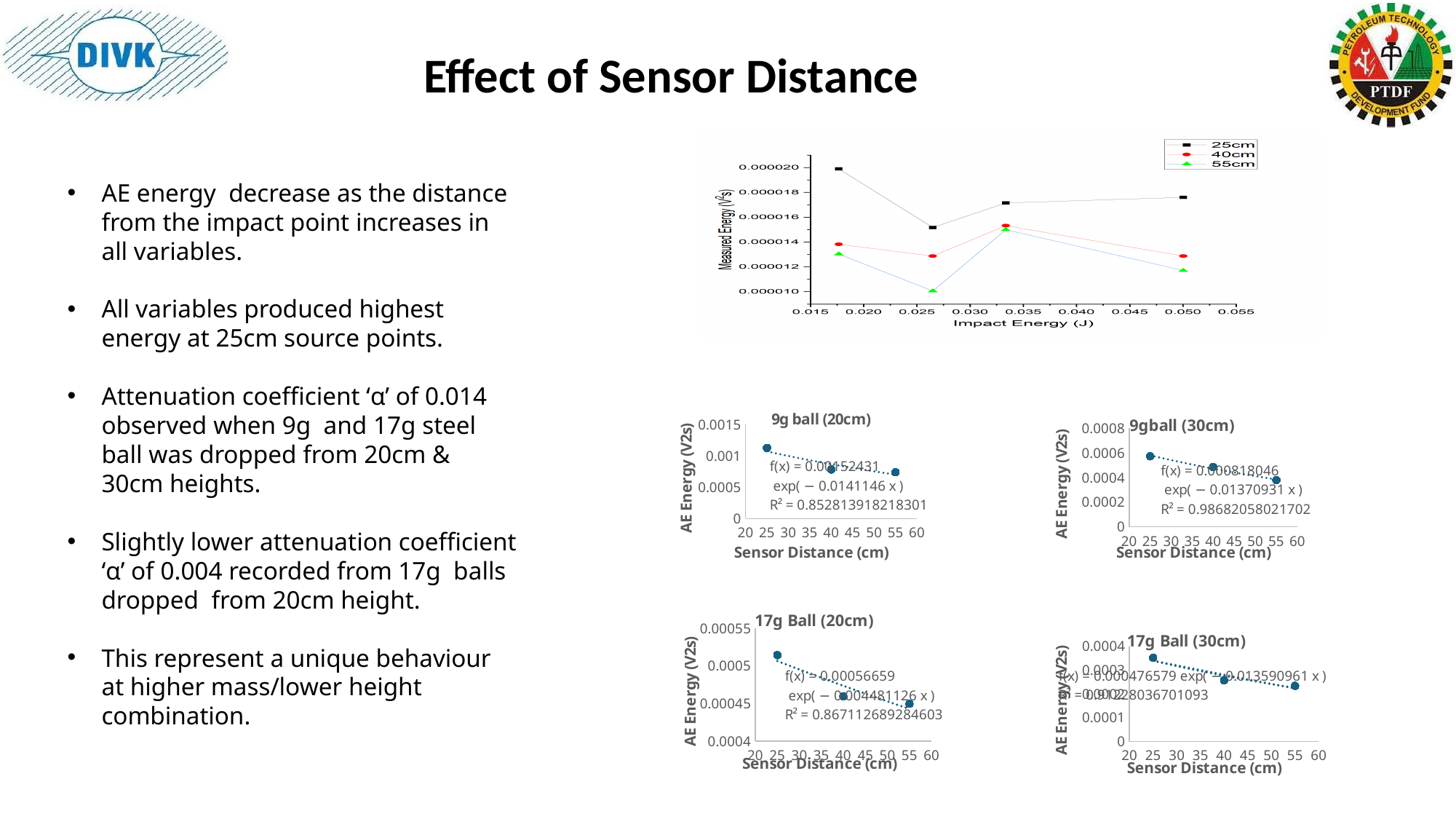
In the '17g Ball (20cm)' chart, is the value at 55 cm greater or less than 0.0005? less What is the x-axis label of the top chart? Impact Energy (J) What is the x-axis label of the '17g Ball (30cm)' chart? Sensor Distance (cm) In the '9gball (30cm)' chart, is the value at 25 cm greater or less than 0.0004? greater In the '17g Ball (30cm)' chart, is the value at 25 cm greater or less than 0.0003? greater What kind of chart is the top chart with the 25cm, 40cm and 55cm legend? line chart How many series does the legend of the top chart list? 3 In the top chart, which series has the highest measured energy across the impact energies? 25cm How many data points are plotted in the '9g ball (20cm)' chart? 3 In the '9g ball (20cm)' chart, do the AE energy values rise or fall as sensor distance increases? fall